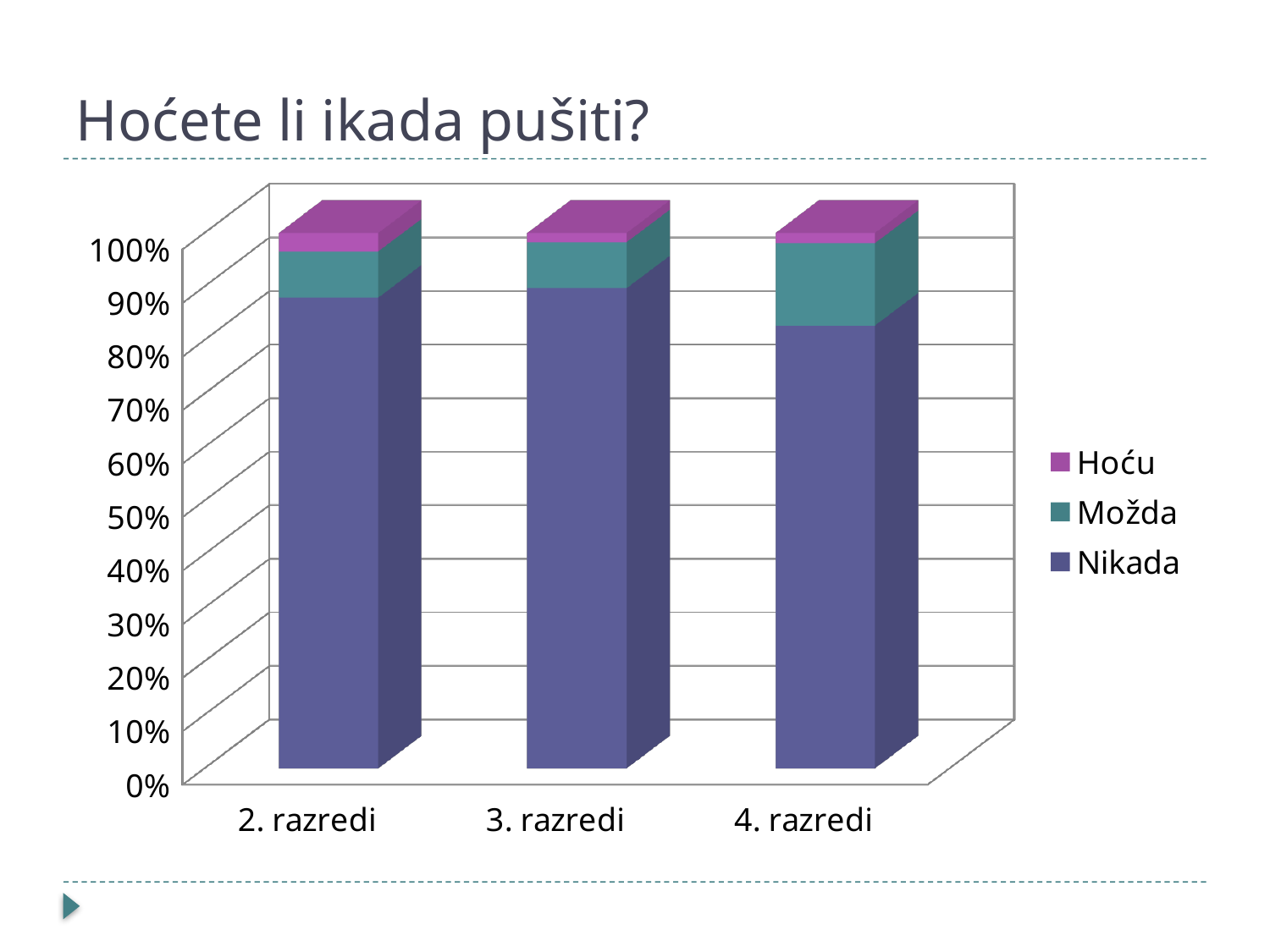
What kind of chart is shown on the slide? stacked bar chart How many categories are shown on the x axis of the chart? 3 Is the Nikada share for 4. razredi greater or less than 90%? less Is the Nikada share larger for 2. razredi or for 4. razredi? 2. razredi Which category has the largest Možda share? 4. razredi Is the Nikada share for 3. razredi greater or less than 80%? greater Is the Nikada share for 2. razredi greater or less than 80%? greater How many series does the chart's legend list? 3 What is the title of the chart on the slide? Hoćete li ikada pušiti? Which category has the smallest Nikada share? 4. razredi Which series are listed in the chart's legend? Hoću, Možda, Nikada